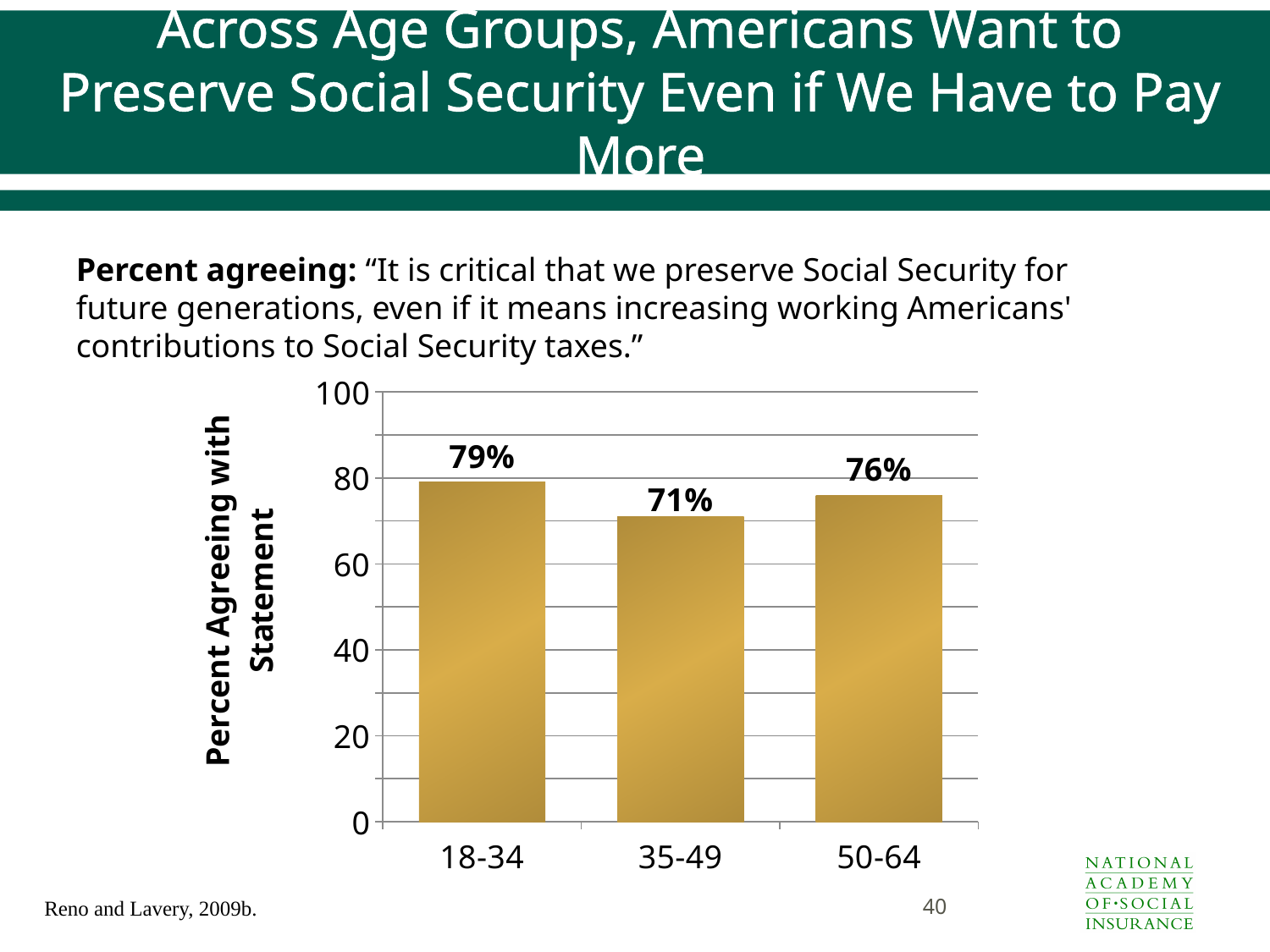
Is the value for the 35-49 age group greater or less than 80? less What percent of the 50-64 age group agrees with the statement? 76% What percent of the 18-34 age group agrees with the statement? 79% Which age group has a higher percent agreeing: 18-34 or 50-64? 18-34 What is the difference in percent agreeing between the 50-64 and 35-49 age groups? 5 percentage points What percent of the 35-49 age group agrees with the statement? 71% What kind of chart is shown on the slide? Bar chart What is the label of the vertical axis of the chart? Percent Agreeing with Statement What is the difference in percent agreeing between the 18-34 and 35-49 age groups? 8 percentage points Which age group has the highest percent agreeing with the statement? 18-34 How many age groups are shown in the chart? 3 Which age group has the lowest percent agreeing with the statement? 35-49